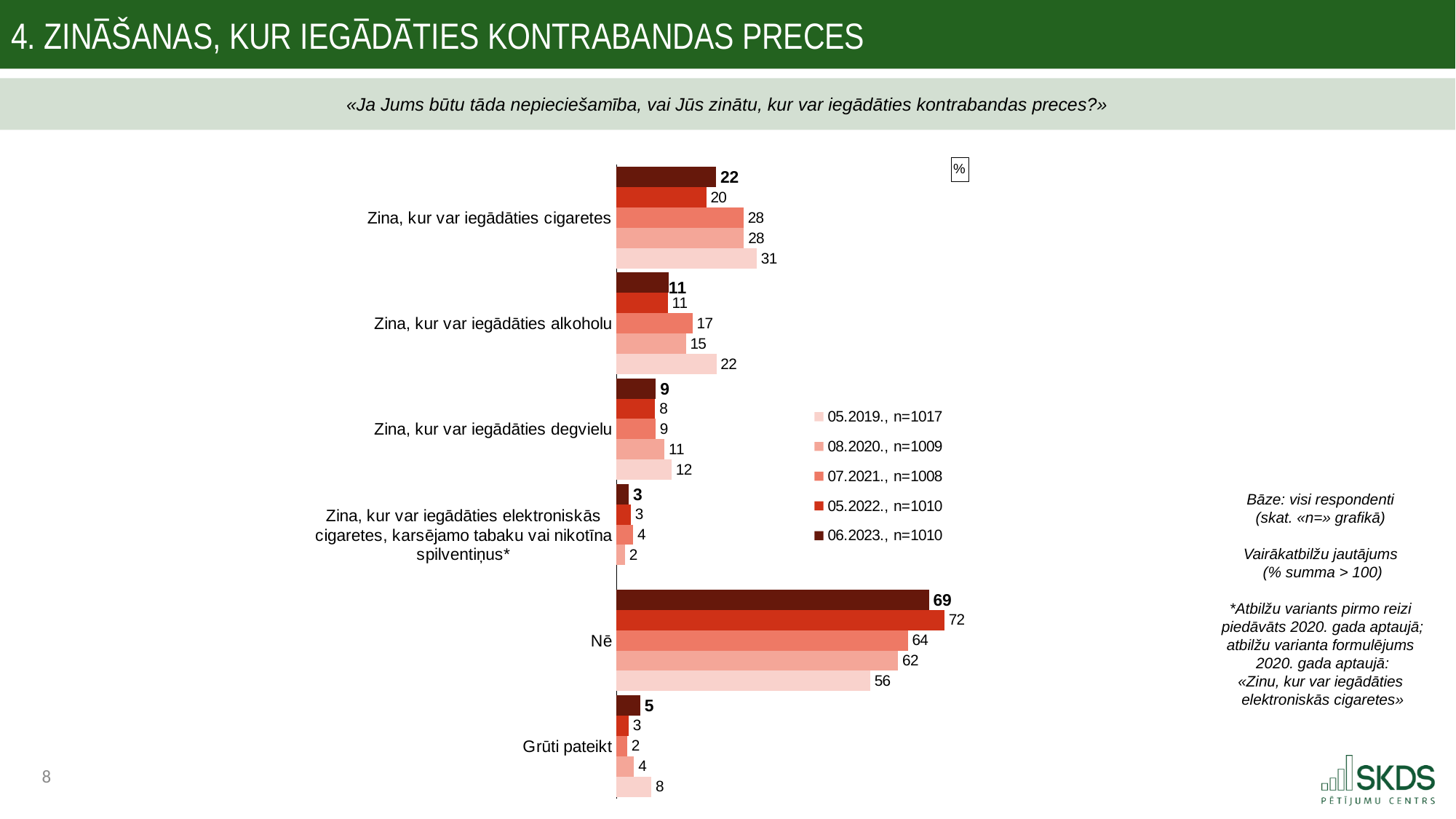
What kind of chart is shown on the slide? bar chart What is the value for "Nē" in the 05.2019 series? 56 What is the value for "Zina, kur var iegādāties alkoholu" in the 07.2021 series? 17 How many series does the legend list? 5 What is the difference between the 05.2022 and 06.2023 values for "Nē"? 3 Which category has the highest value in the 06.2023 series? Nē How many categories are shown on the chart? 6 What is the sample size (n) shown in the legend for the 08.2020 series? n=1009 What is the difference between the 05.2019 and 06.2023 values for "Zina, kur var iegādāties alkoholu"? 11 What is the value for "Zina, kur var iegādāties cigaretes" in the 06.2023 series? 22 Which is larger for "Zina, kur var iegādāties cigaretes": the 05.2019 value or the 06.2023 value? 05.2019